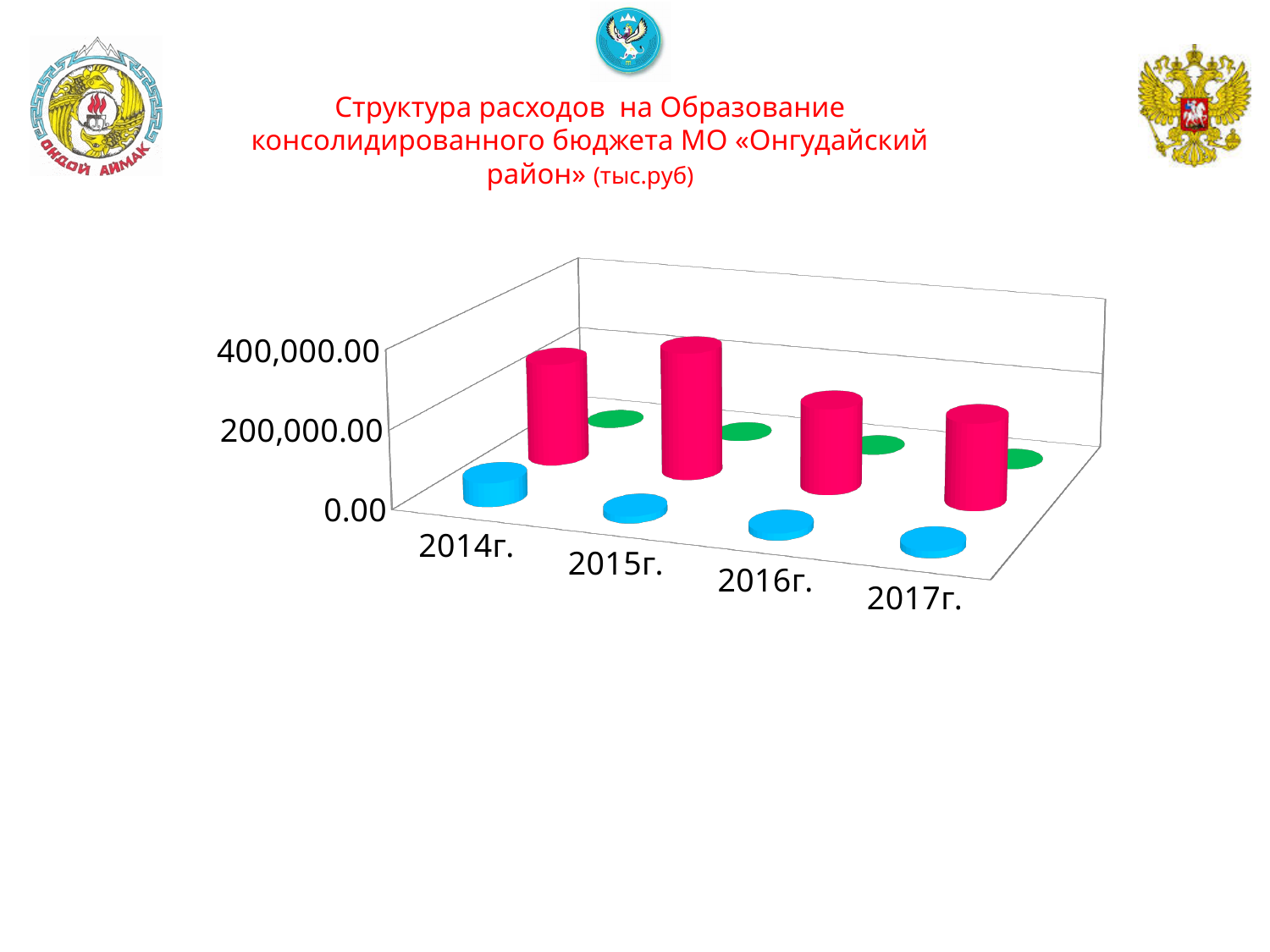
What is the title of the chart on the slide? Структура расходов на Образование консолидированного бюджета МО «Онгудайский район» (тыс.руб) What is the highest value shown on the vertical axis of the chart? 400,000.00 For 2014г., which is larger: the red series or the blue series? the red series Which series has the tallest cylinders in every year? the red series Is the value of the blue series for 2017г. greater or less than 200,000.00? less How many years are shown on the x axis of the chart? 4 How many differently coloured series of cylinders are plotted in the chart? 3 What kind of chart is shown on the slide? bar chart Is the value of the green series for 2015г. greater or less than 200,000.00? less For 2016г., which is larger: the red series or the green series? the red series Is the value of the blue series for 2014г. greater or less than 200,000.00? less